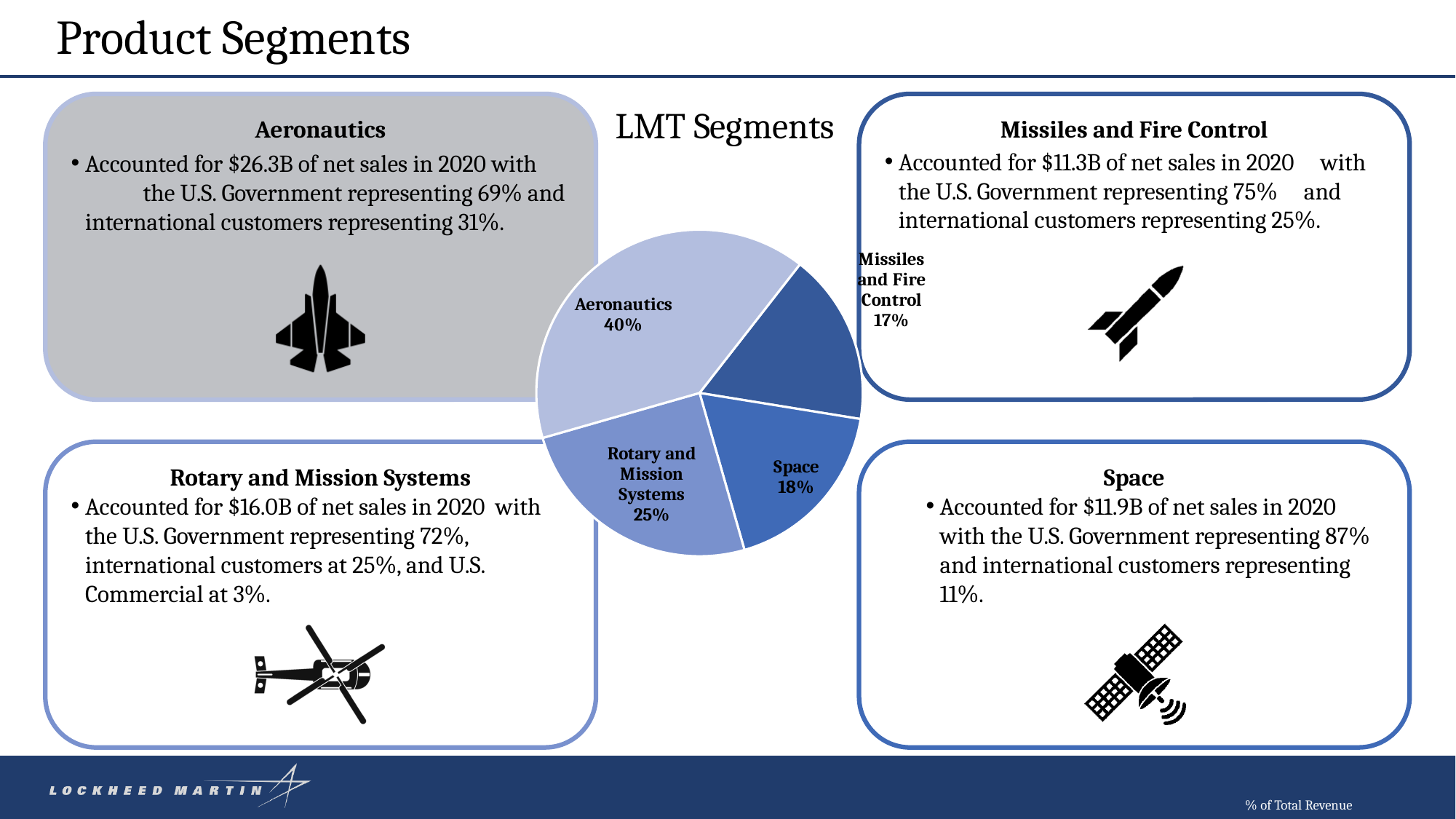
What share of the pie does Rotary and Mission Systems represent? 25% What share of the pie does Aeronautics represent? 40% Which segment has the largest share of the pie? Aeronautics What share of the pie does Missiles and Fire Control represent? 17% What is the title of the chart? LMT Segments What is the difference in percentage points between Space and Missiles and Fire Control? 1 What type of chart is shown on the slide? pie chart What share of the pie does Space represent? 18% Which segment has the smallest share of the pie? Missiles and Fire Control What is the difference in percentage points between Aeronautics and Rotary and Mission Systems? 15 Which is larger, the share for Rotary and Mission Systems or the share for Space? Rotary and Mission Systems How many segments does the pie chart have? 4